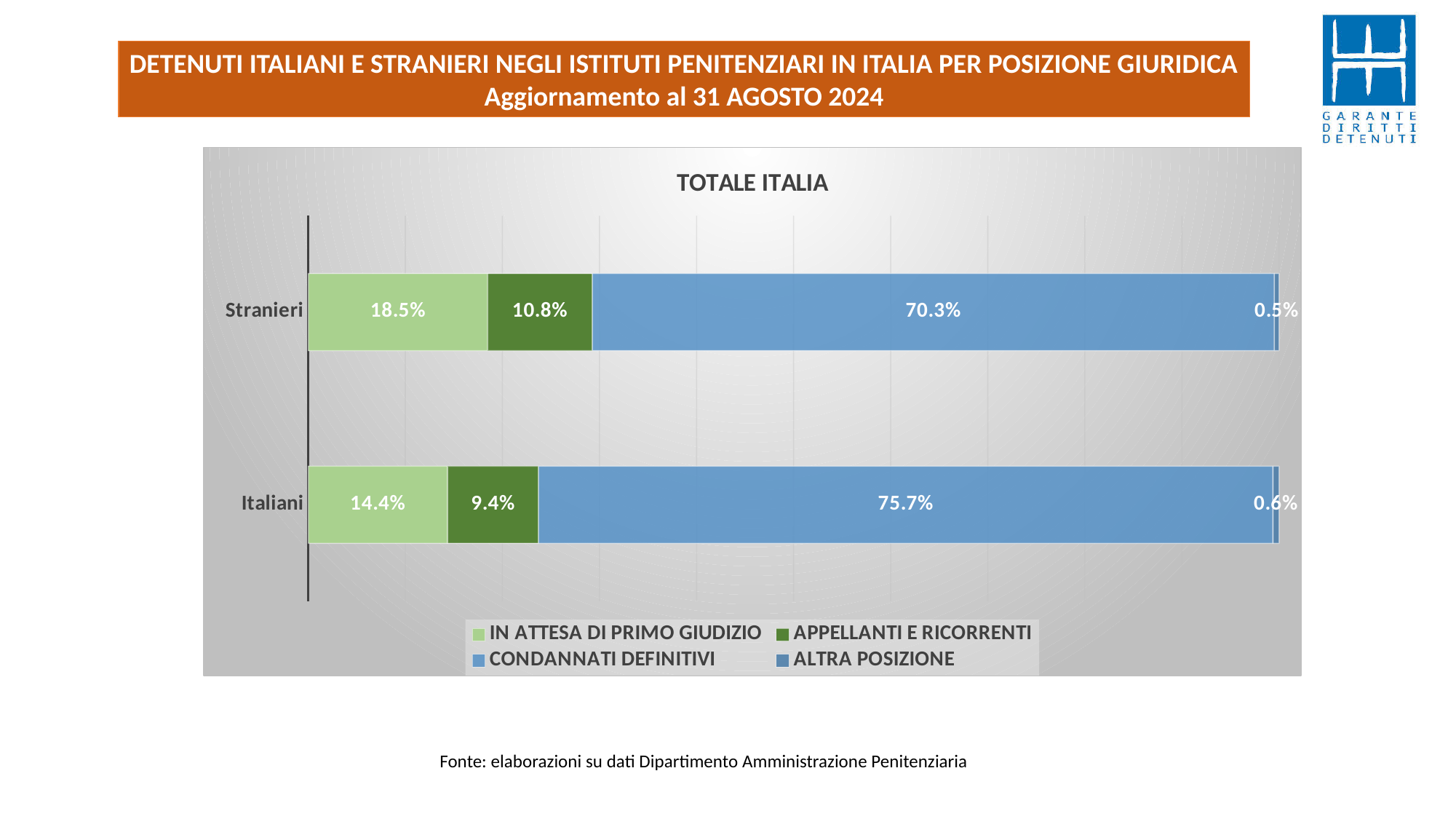
How many categories are shown on the chart? 2 What is the value for CONDANNATI DEFINITIVI for Italiani? 75.7% What is the difference between the CONDANNATI DEFINITIVI values for Italiani and Stranieri? 5.4% What is the value for ALTRA POSIZIONE for Italiani? 0.6% Which category has the higher value for IN ATTESA DI PRIMO GIUDIZIO, Stranieri or Italiani? Stranieri How many series does the legend list? 4 What is the value for IN ATTESA DI PRIMO GIUDIZIO for Stranieri? 18.5% Which category has the higher value for CONDANNATI DEFINITIVI, Stranieri or Italiani? Italiani What is the difference between the APPELLANTI E RICORRENTI values for Stranieri and Italiani? 1.4% What is the value for APPELLANTI E RICORRENTI for Stranieri? 10.8% What is the title of the chart? TOTALE ITALIA What kind of chart is shown on the slide? Stacked bar chart